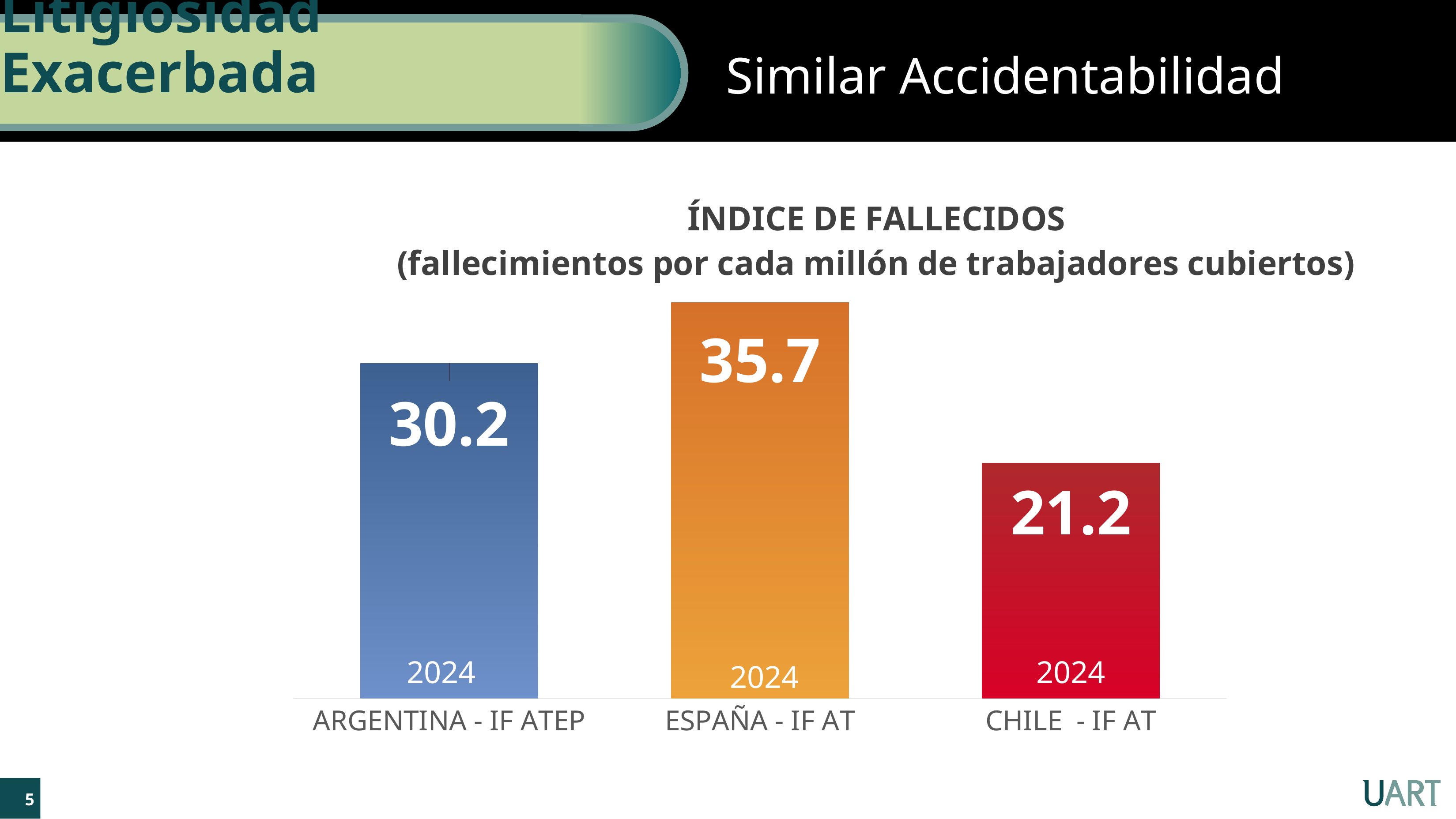
What is the difference between the values for ESPAÑA - IF AT and ARGENTINA - IF ATEP? 5.5 What is the value for ARGENTINA - IF ATEP? 30.2 Which category has the highest value? ESPAÑA - IF AT Which is larger, the value for ARGENTINA - IF ATEP or the value for CHILE - IF AT? ARGENTINA - IF ATEP What is the title of the chart? ÍNDICE DE FALLECIDOS (fallecimientos por cada millón de trabajadores cubiertos) Which category has the lowest value? CHILE - IF AT What kind of chart is shown on the slide? bar chart Which year is labelled on each bar of the chart? 2024 What is the value for CHILE - IF AT? 21.2 How many categories are shown in the chart? 3 What is the value for ESPAÑA - IF AT? 35.7 What is the difference between the values for ARGENTINA - IF ATEP and CHILE - IF AT? 9.0